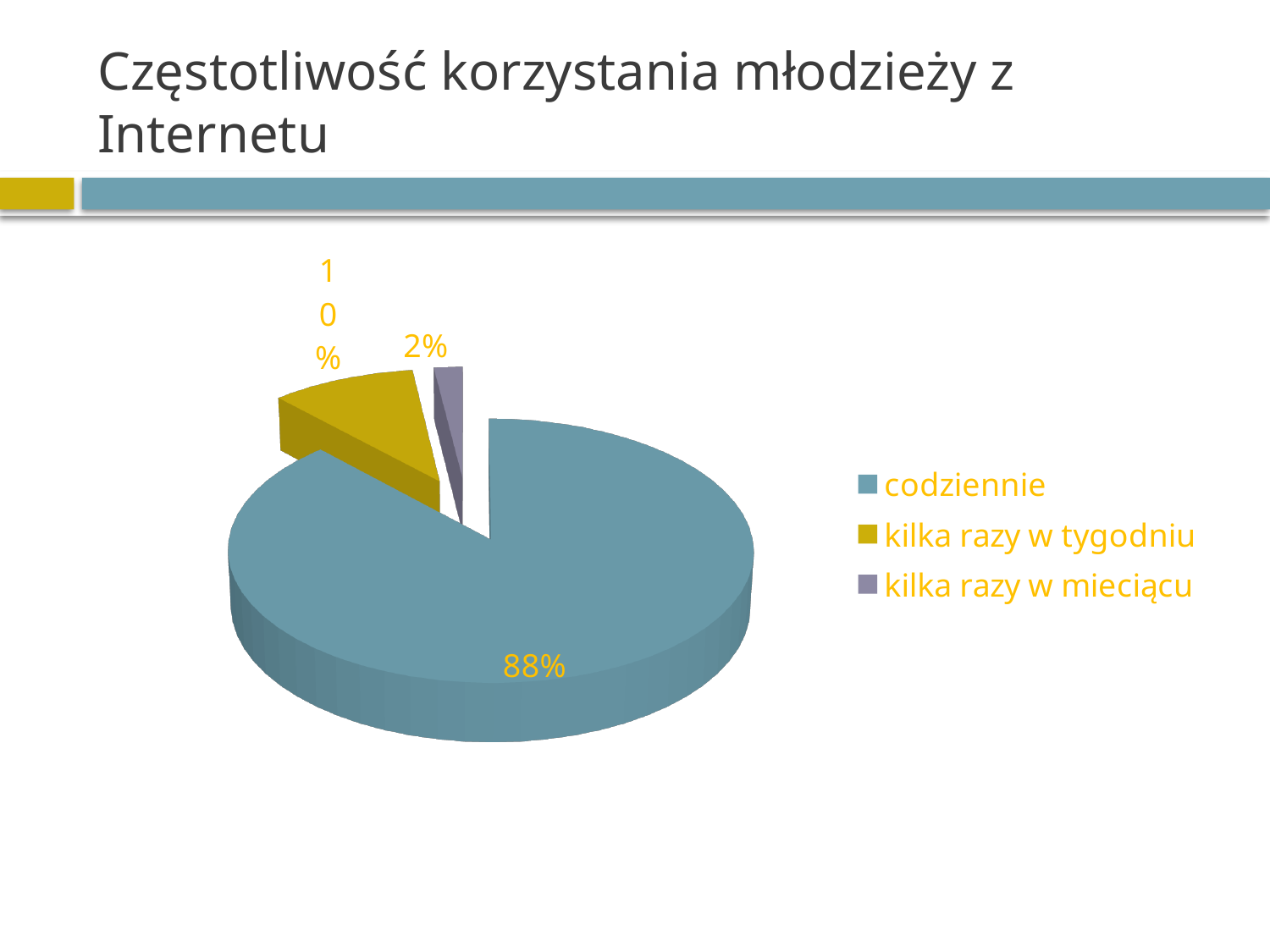
How many categories does the pie chart show? 3 What colour is the slice for 'codziennie'? teal blue What is the difference in percentage points between 'kilka razy w tygodniu' and 'kilka razy w mieciącu'? 8 What percentage is shown for 'kilka razy w tygodniu'? 10% What kind of chart is shown on the slide? pie chart Which is larger, the slice for 'kilka razy w tygodniu' or the slice for 'kilka razy w mieciącu'? kilka razy w tygodniu What percentage of the pie is labelled for 'codziennie'? 88% Which category has the largest slice of the pie? codziennie What percentage is shown for 'kilka razy w mieciącu'? 2% What is the title of the slide containing the chart? Częstotliwość korzystania młodzieży z Internetu Which category has the smallest slice of the pie? kilka razy w mieciącu What is the difference in percentage points between 'codziennie' and 'kilka razy w tygodniu'? 78